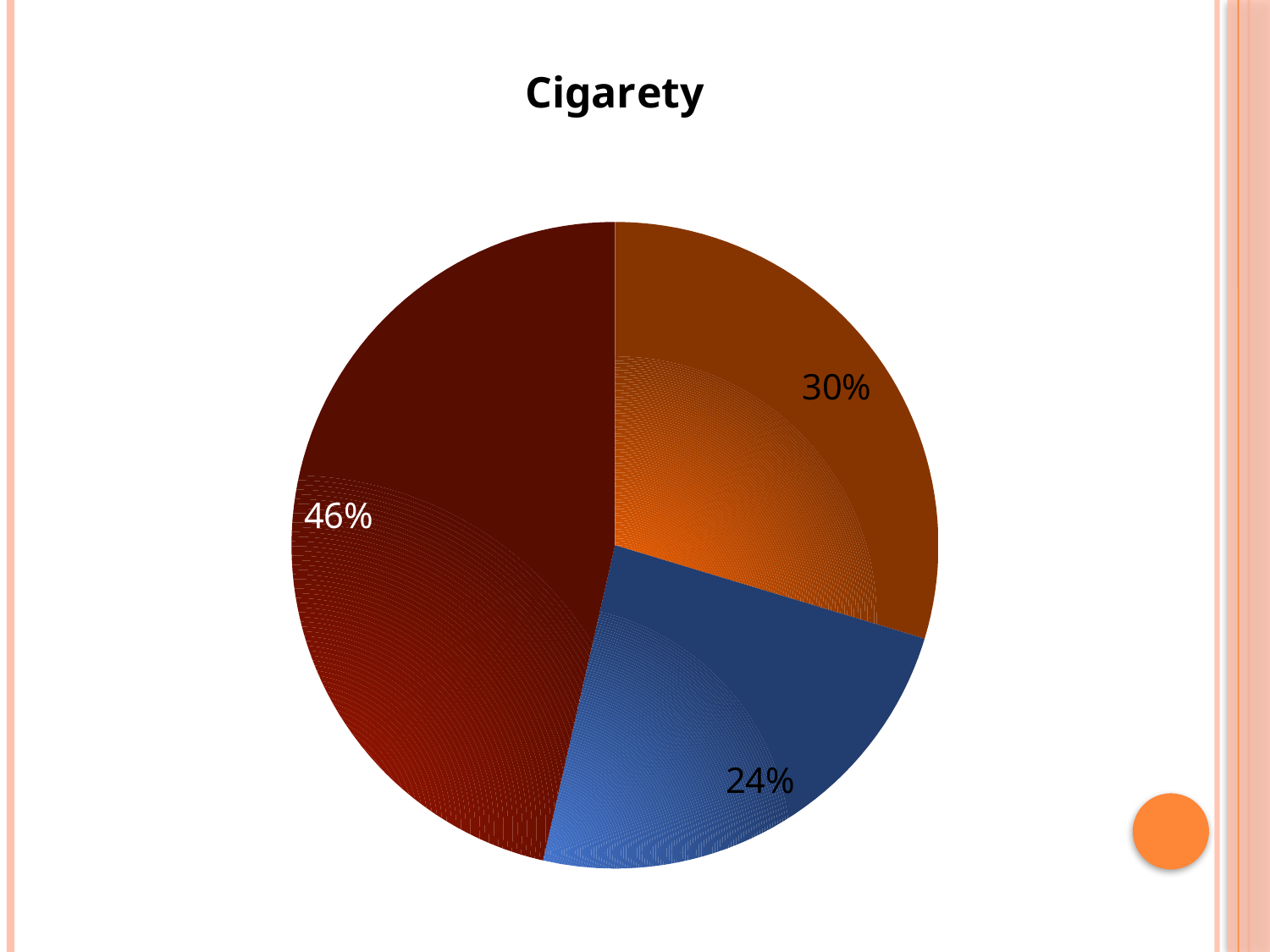
What is the title of the chart? Cigarety What percentage is shown on the blue slice? 24% What share does the largest slice of the pie represent? 46% What is the difference between the largest slice and the smallest slice? 22% What percentage is shown on the dark red slice on the left? 46% How many slices does the pie chart have? 3 Which is larger, the blue slice or the orange-brown slice? the orange-brown slice What is the difference between the 30% slice and the 24% slice? 6% What share does the smallest slice of the pie represent? 24% What percentage is shown on the orange-brown slice at the top right? 30% What kind of chart is shown on the slide? pie chart Does the chart include a legend? No